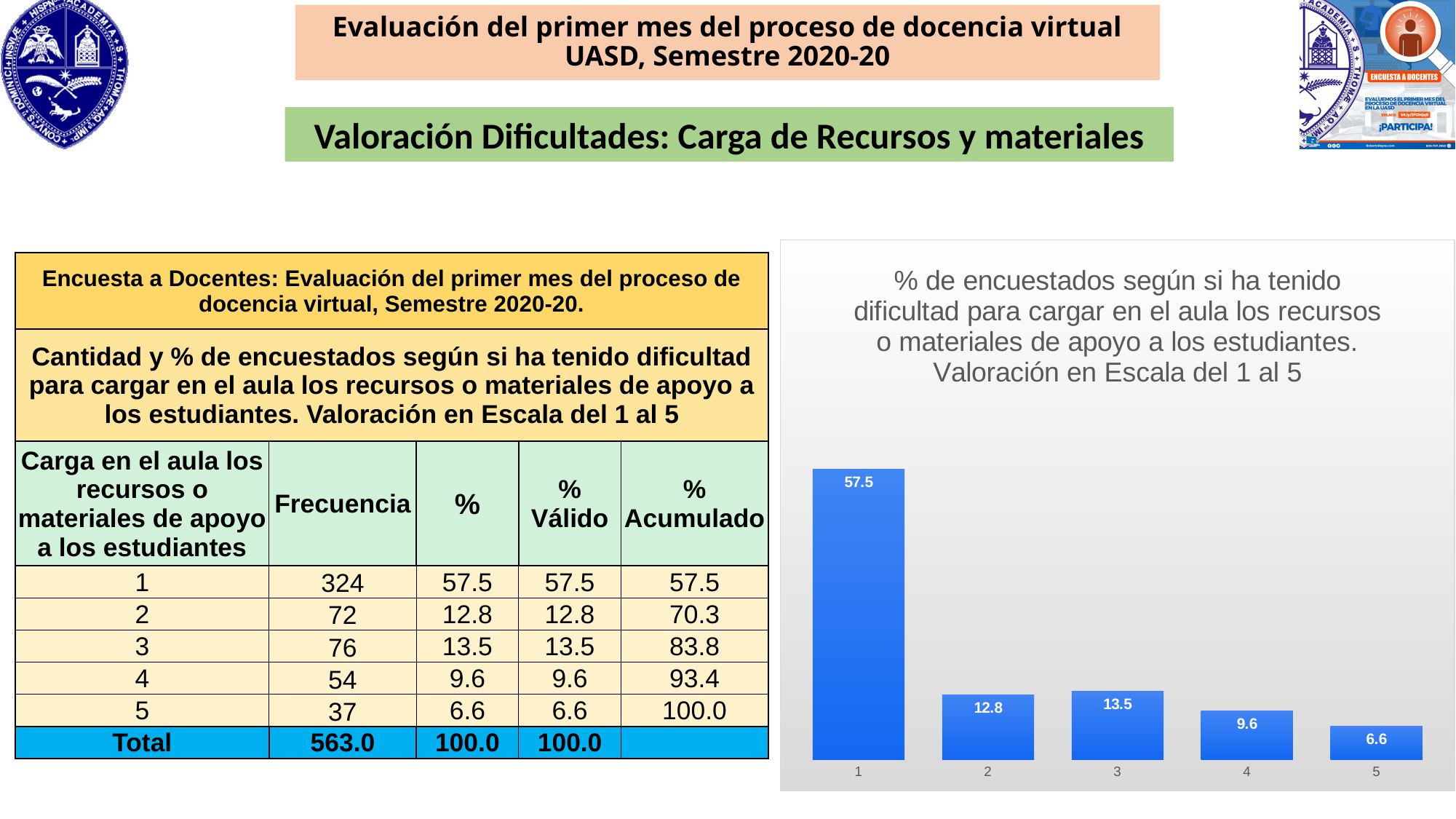
Which category has the lowest value in the bar chart? 5 What is the difference between the values for category 3 and category 4 in the bar chart? 3.9 What kind of chart is shown on the slide? Bar chart What is the value shown for category 5 in the bar chart? 6.6 Which has a larger value in the bar chart, category 2 or category 3? 3 Which has a larger value in the bar chart, category 4 or category 5? 4 How many categories are shown on the x axis of the bar chart? 5 What is the difference between the values for category 1 and category 2 in the bar chart? 44.7 What colour are the bars in the chart? Blue What is the value shown for category 1 in the bar chart? 57.5 Which category has the highest value in the bar chart? 1 What is the value shown for category 3 in the bar chart? 13.5